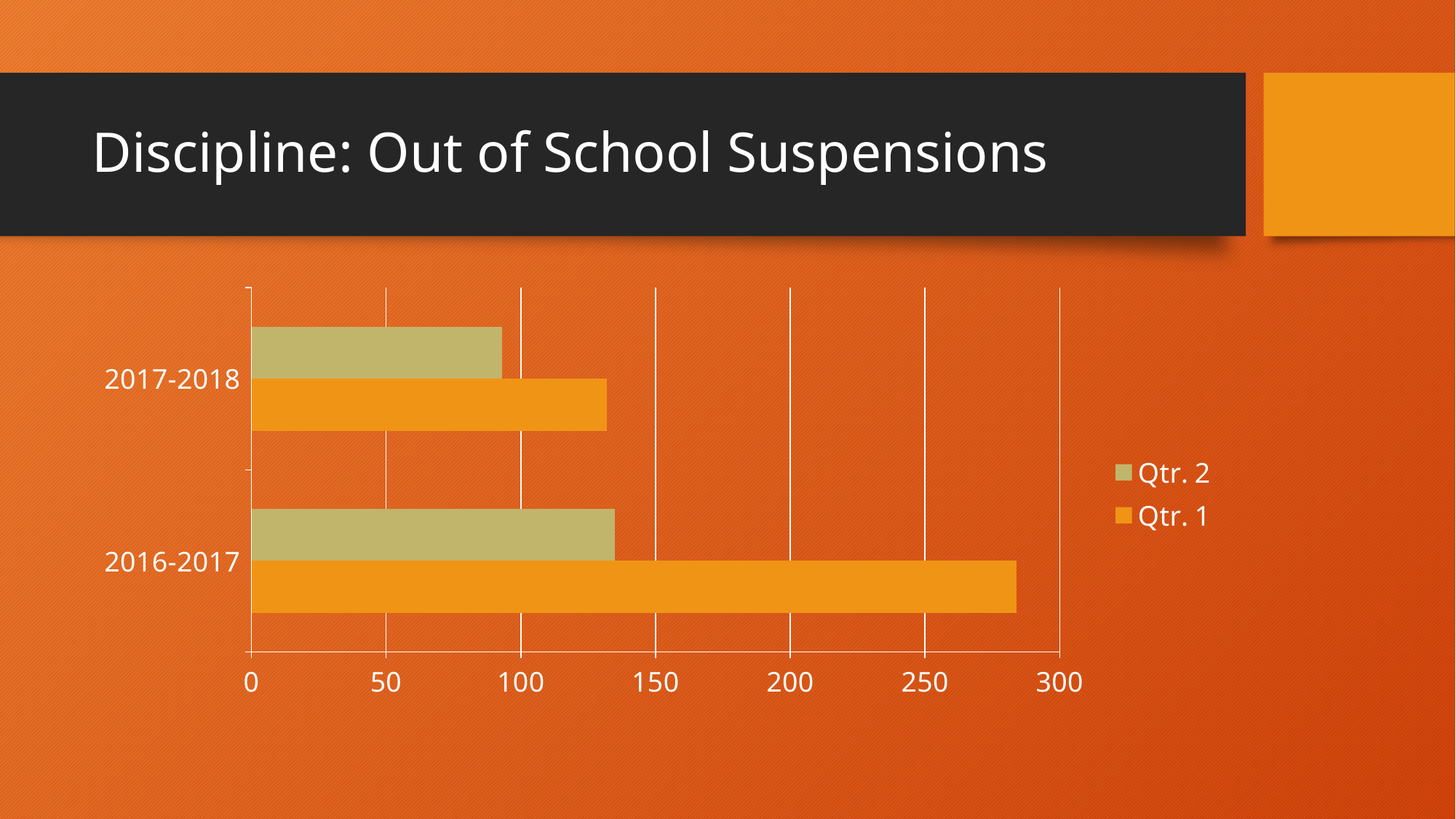
How many series does the legend list? 2 Is the Qtr. 2 value for 2016-2017 greater or less than 100? greater What is the title of the slide containing the chart? Discipline: Out of School Suspensions How many school-year categories are shown on the chart? 2 For 2016-2017, which quarter has the larger value, Qtr. 1 or Qtr. 2? Qtr. 1 Which school year and quarter has the longest bar on the chart? 2016-2017, Qtr. 1 Is the Qtr. 1 value for 2017-2018 greater or less than 150? less Is the Qtr. 2 value for 2017-2018 greater or less than 100? less What kind of chart is shown on the slide? bar chart Which series is shown in orange in the legend? Qtr. 1 Which school year has the higher Qtr. 1 value, 2016-2017 or 2017-2018? 2016-2017